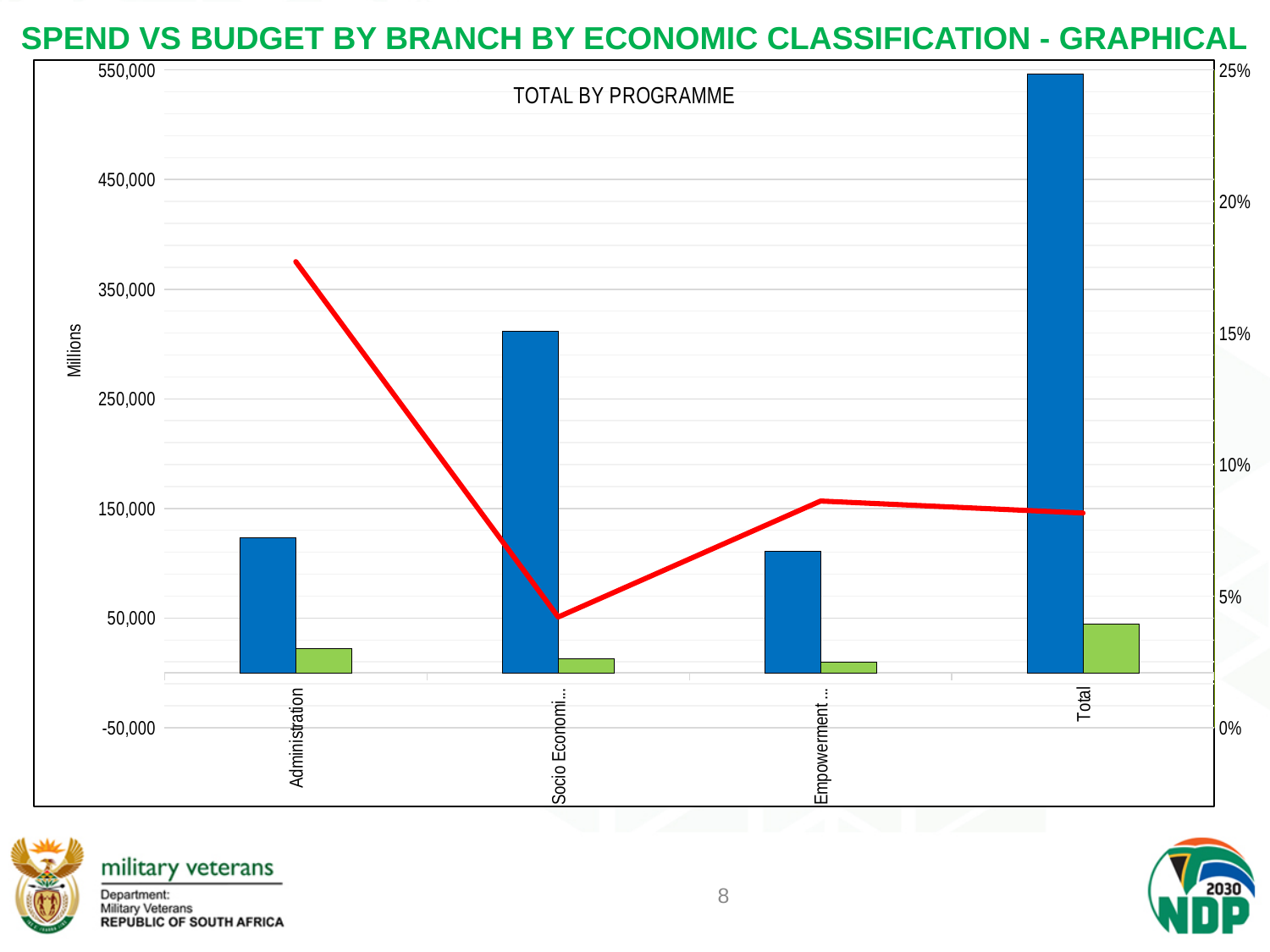
What is the label on the left vertical axis of the chart? Millions What is the title of the chart? TOTAL BY PROGRAMME Is the blue bar for Total greater or less than 450,000? greater How many categories are shown on the x axis of the chart? 4 Which category has the highest point on the red line? Administration What type of chart is shown on the slide? Bar chart with a line Is the blue bar for Administration greater or less than 150,000? less Is the red line value for Administration greater or less than 15%? greater Which is larger, the blue bar for Administration or the blue bar for Total? Total Which category has the tallest blue bar? Total